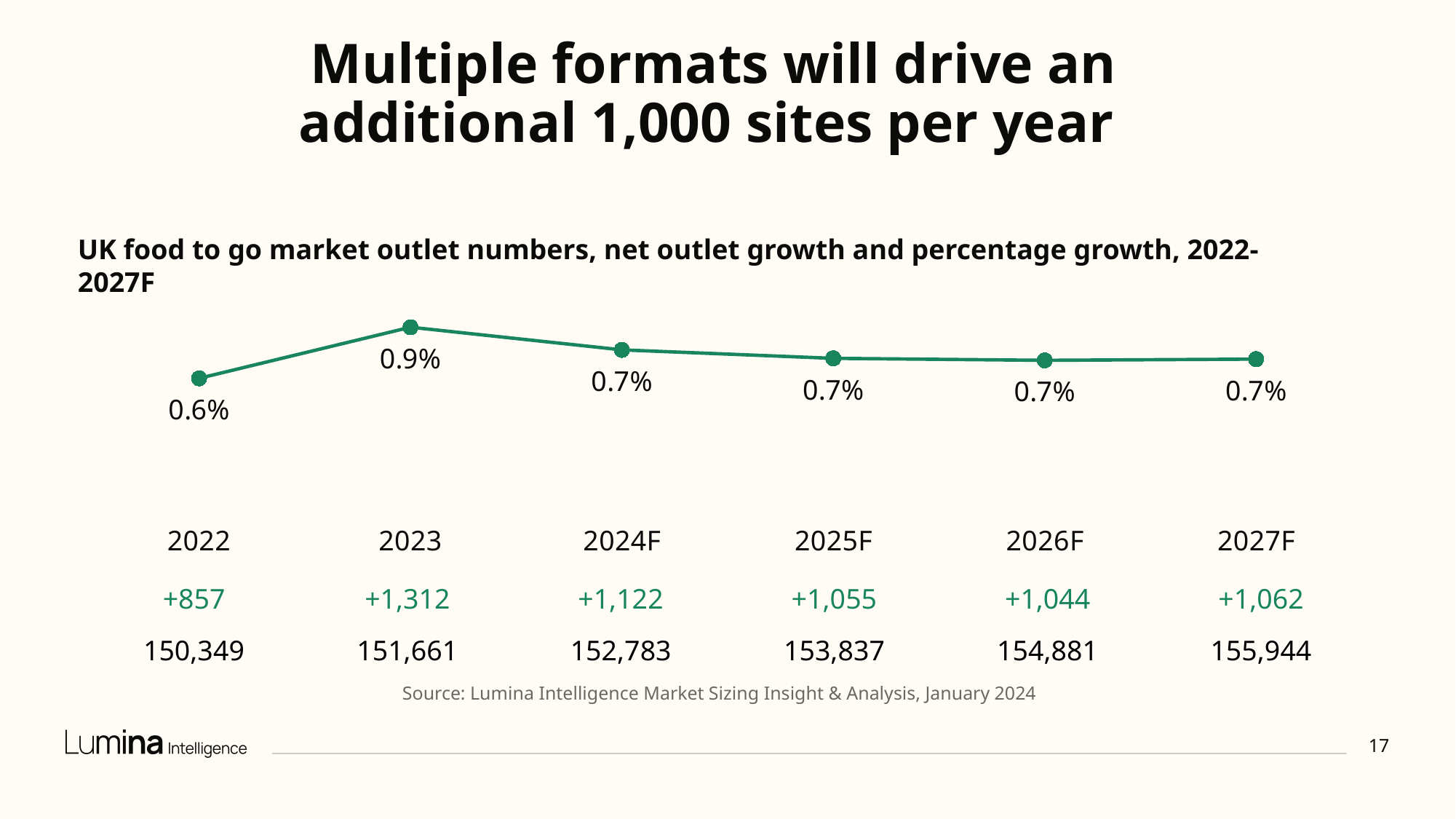
What is the title of the chart? UK food to go market outlet numbers, net outlet growth and percentage growth, 2022-2027F What is the percentage growth shown for 2022? 0.6% Does the percentage growth rise or fall from 2022 to 2023? Rise How many data points are plotted on the line? 6 By how much does the outlet number in 2027F exceed the outlet number in 2022? 5,595 Which year has the larger net outlet growth, 2023 or 2024F? 2023 What is the percentage growth shown for 2023? 0.9% Which year has the lowest percentage growth on the line? 2022 Which year has the highest percentage growth on the line? 2023 What kind of chart is shown on the slide? Line chart What is the outlet number shown for 2027F? 155,944 What is the net outlet growth shown for 2024F? +1,122